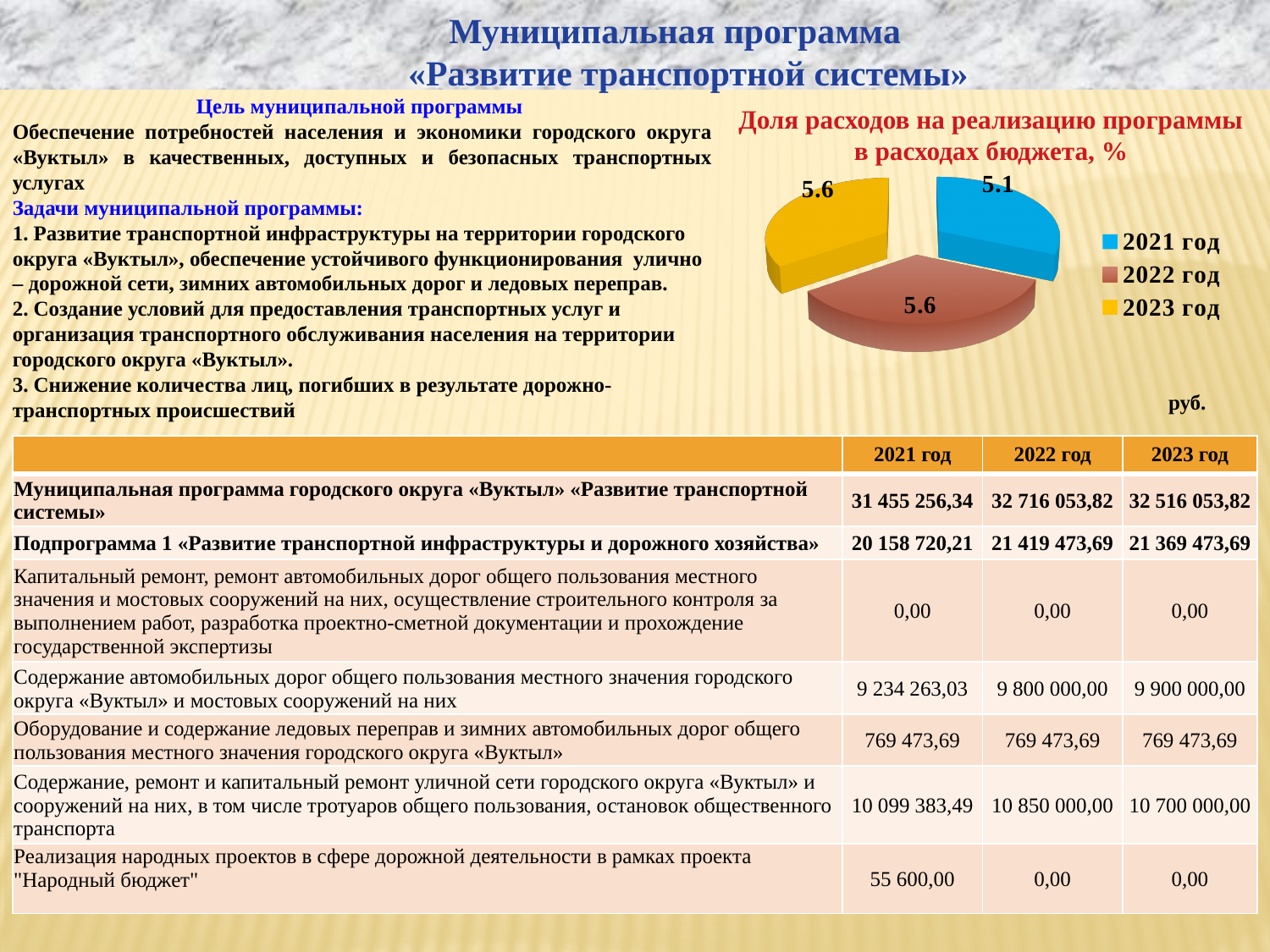
What is the title of the chart on the slide? Доля расходов на реализацию программы в расходах бюджета, % How many slices does the pie chart have? 3 What is the value for 2023 год in the pie chart? 5.6 How many entries does the legend of the pie chart list? 3 Which is larger in the pie chart, the value for 2021 год or the value for 2022 год? 2022 год What is the difference between the values for 2022 год and 2021 год in the pie chart? 0.5 What kind of chart is shown on the slide? Pie chart What is the value for 2021 год in the pie chart? 5.1 Which colour represents 2023 год in the pie chart? Yellow What is the value for 2022 год in the pie chart? 5.6 Which year has the lowest value in the pie chart? 2021 год